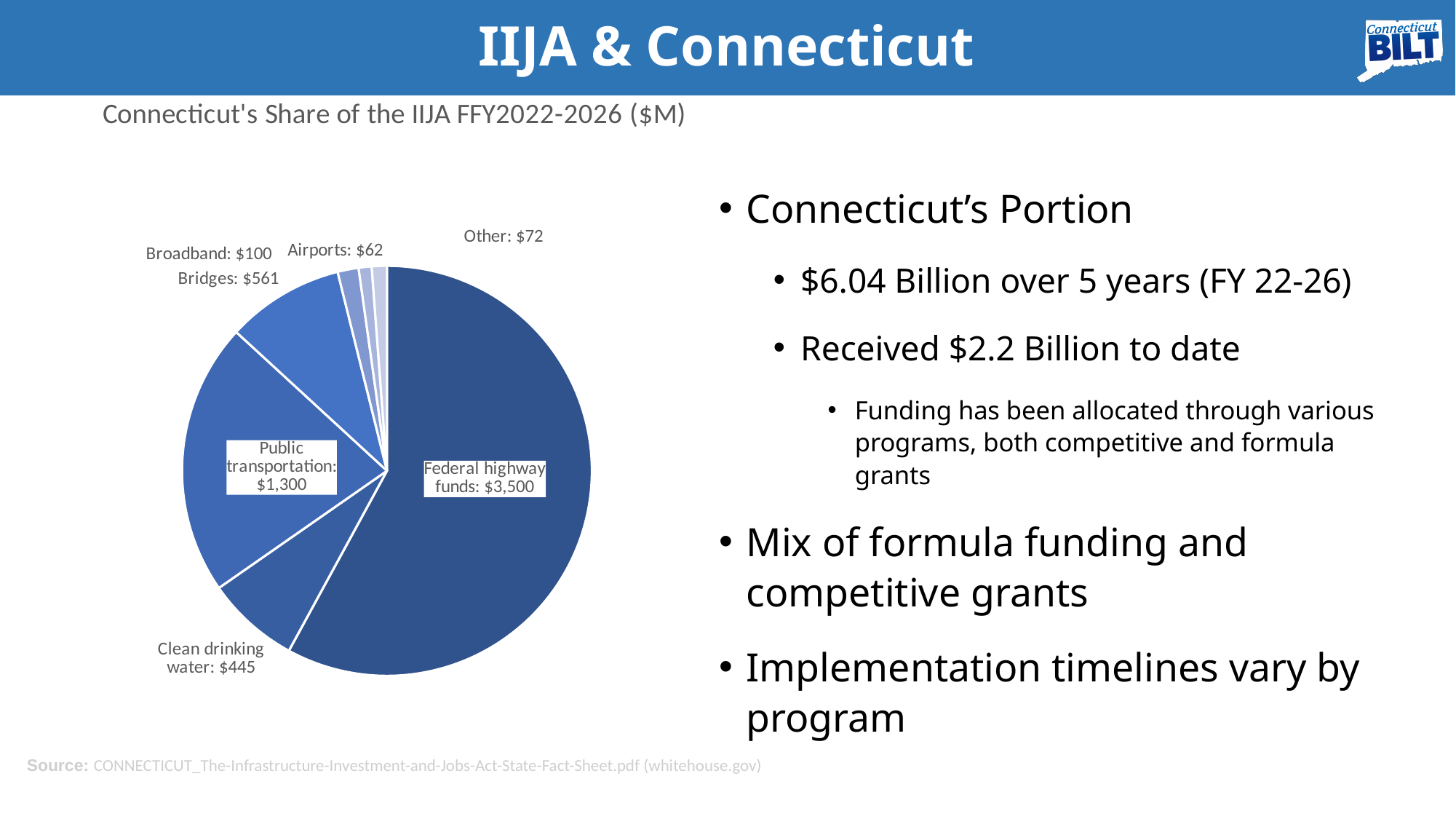
What is the difference between Federal highway funds and Public transportation in the pie chart? $2,200 Which category has the largest slice in the pie chart? Federal highway funds What type of chart is shown on the slide? Pie chart What is the difference between Bridges and Clean drinking water in the pie chart? $116 How many categories are shown in the pie chart? 7 Which is larger in the pie chart, Broadband or Other? Broadband What is the value for Federal highway funds in the pie chart? $3,500 Which category has the smallest slice in the pie chart? Airports What is the value for Airports in the pie chart? $62 What is the value for Public transportation in the pie chart? $1,300 What is the value for Bridges in the pie chart? $561 What is the value for Clean drinking water in the pie chart? $445